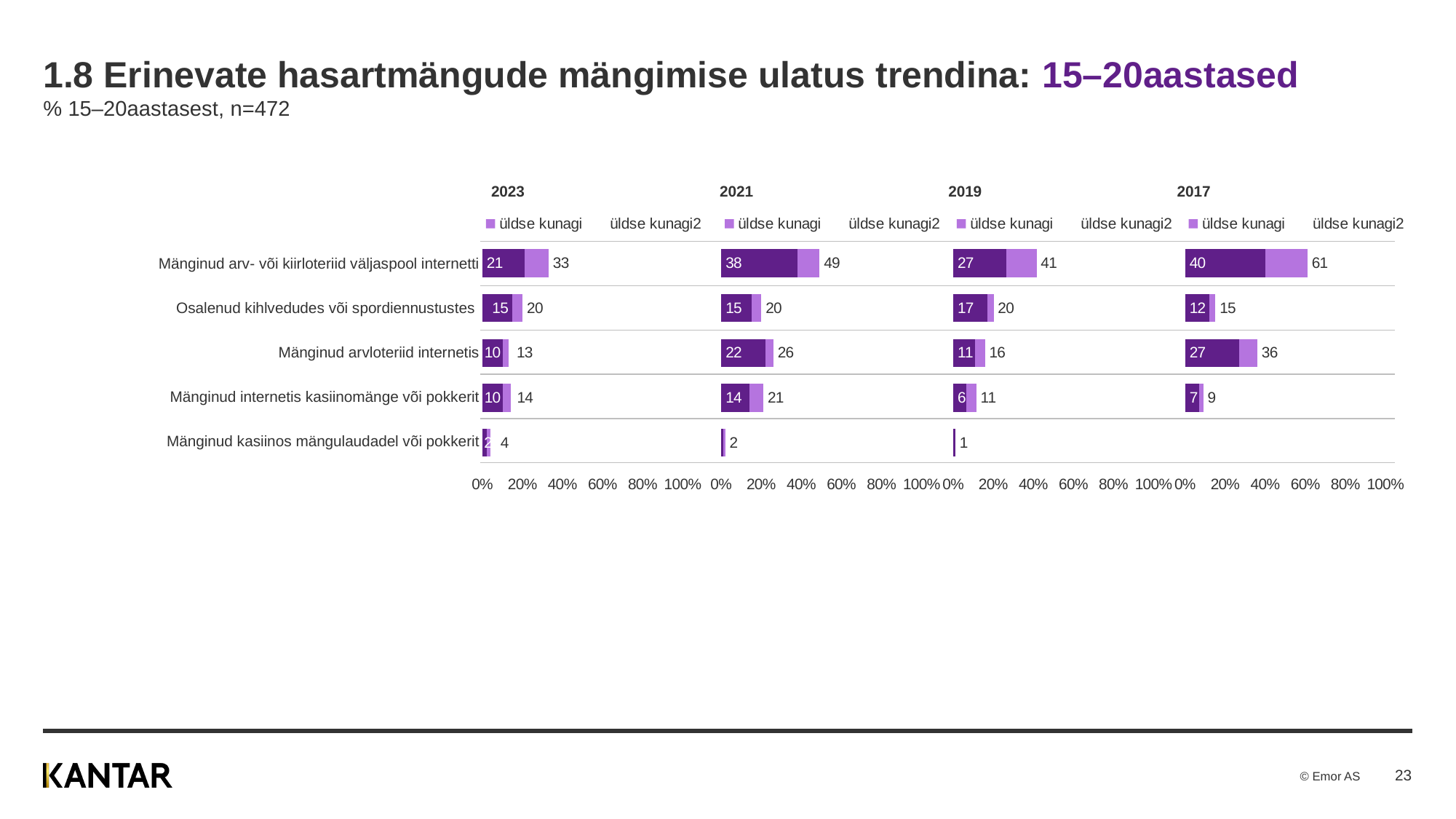
What kind of chart is used on this slide? bar chart In the 2021 chart, what number is printed at the end of the bar for 'Mänginud arv- või kiirloteriid väljaspool internetti'? 49 In the 2019 chart, which category has the highest 'üldse kunagi' value? Mänginud arv- või kiirloteriid väljaspool internetti How many year charts are shown on the slide? 4 How many categories are listed in the 2023 chart? 5 In the 2023 chart, which category has the lowest 'üldse kunagi' value? Mänginud kasiinos mängulaudadel või pokkerit How many series does the legend of the 2023 chart list? 2 In the 2017 chart, is the end of the bar for 'Mänginud arv- või kiirloteriid väljaspool internetti' greater or less than 40%? greater For 'Mänginud arv- või kiirloteriid väljaspool internetti', is the 'üldse kunagi' value larger in the 2017 chart or the 2023 chart? 2017